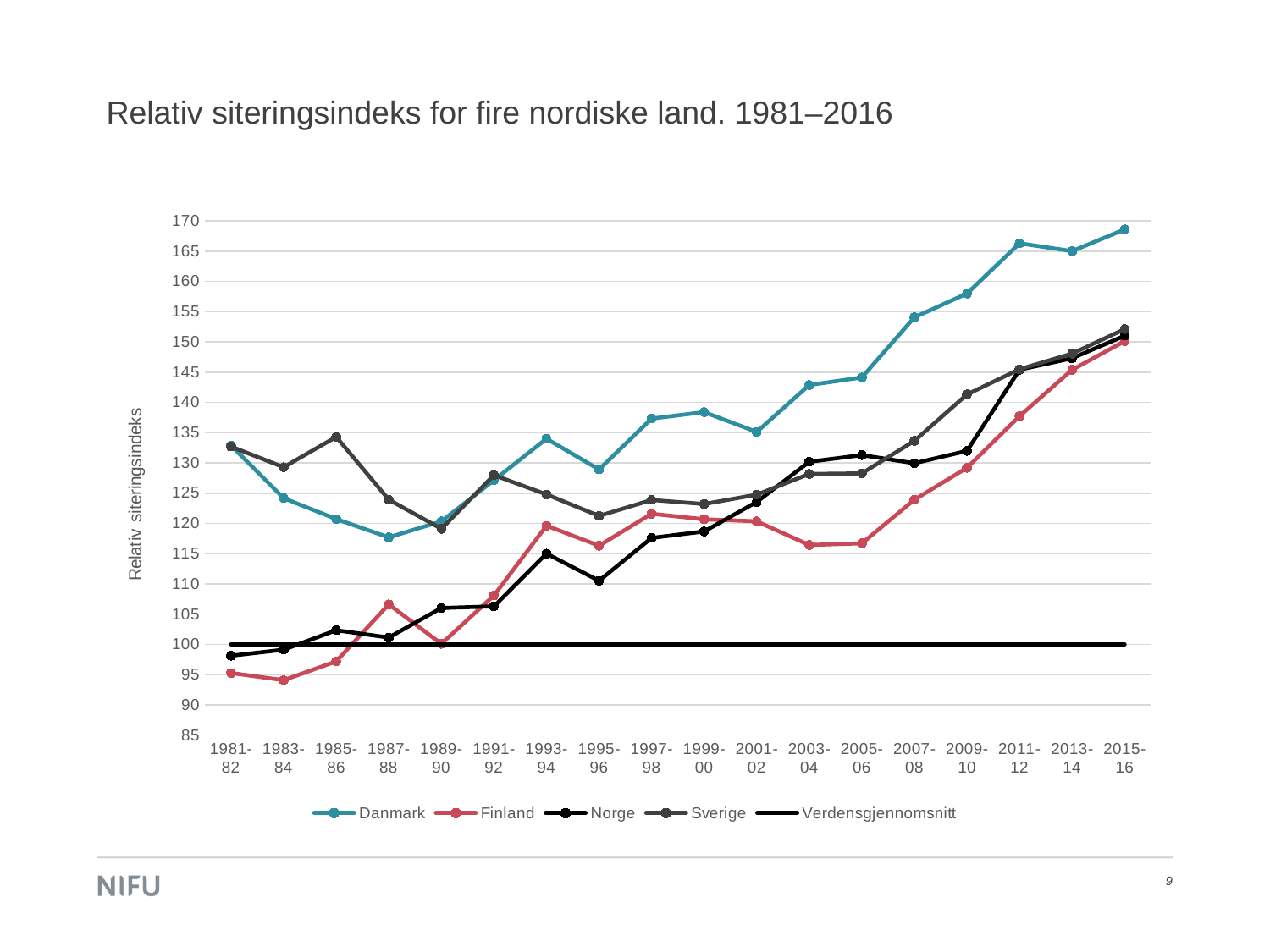
What is the title of the chart? Relativ siteringsindeks for fire nordiske land. 1981–2016 Which country has the highest relative citation index in 2015-16? Danmark Does the Finland line rise or fall from 2005-06 to 2015-16? rise How many series does the legend list? 5 Is the value for Norge in 1995-96 greater or less than 115? less Is the value for Danmark in 2015-16 greater or less than 165? greater Which is higher in 1985-86, Sverige or Danmark? Sverige What kind of chart is shown on the slide? line chart Is the value for Finland in 1983-84 greater or less than 95? less Which country has the lowest relative citation index in 1981-82? Finland How many two-year periods are shown on the x axis? 18 What value does the Verdensgjennomsnitt line sit at across the whole period? 100